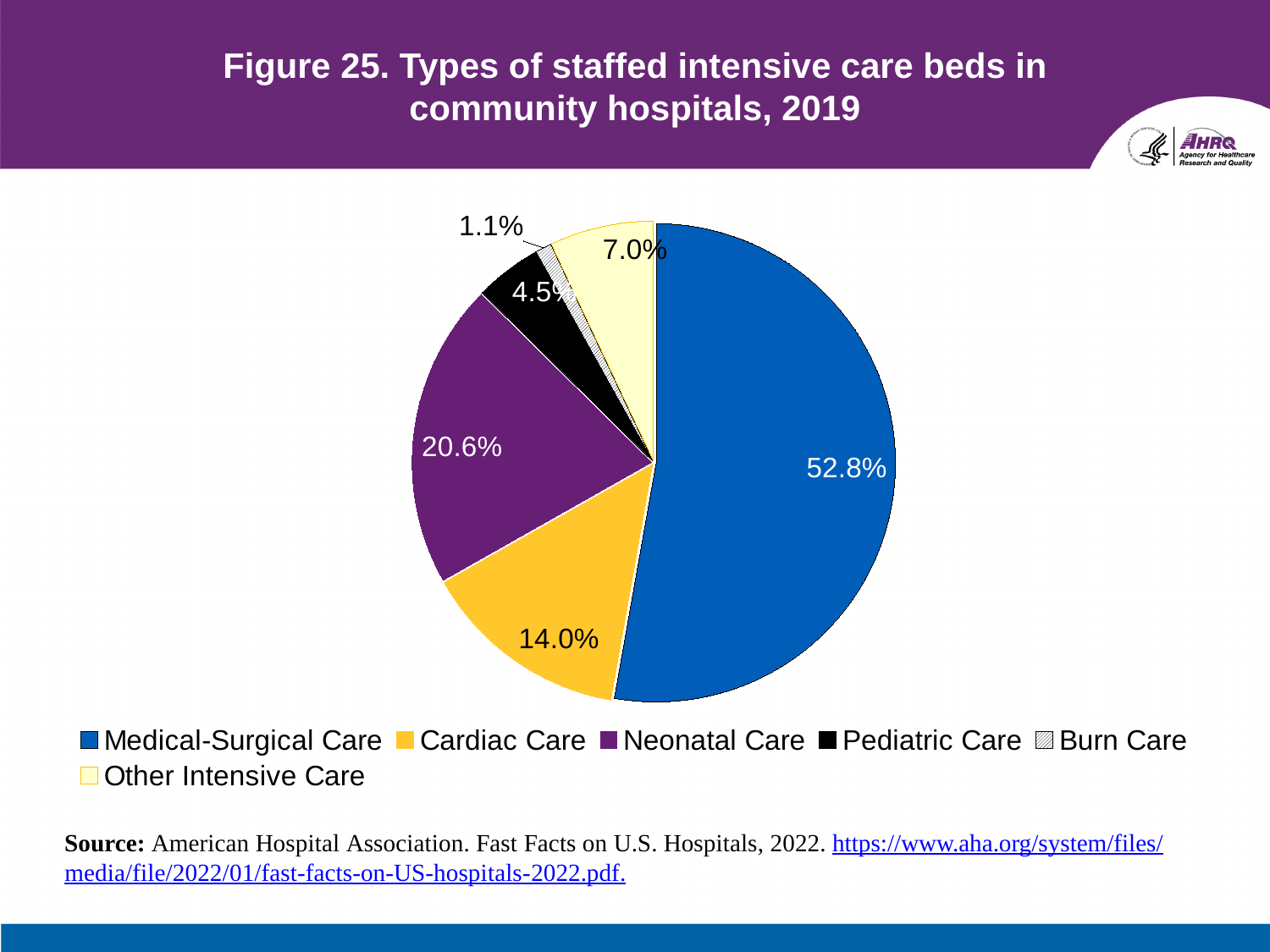
What share of staffed intensive care beds is Medical-Surgical Care? 52.8% Which has a larger share, Other Intensive Care or Pediatric Care? Other Intensive Care What kind of chart is shown on the slide? Pie chart What is the difference in percentage points between the Neonatal Care and Cardiac Care shares? 6.6 percentage points What share of staffed intensive care beds is Pediatric Care? 4.5% What share of staffed intensive care beds is Cardiac Care? 14.0% What share of staffed intensive care beds is Burn Care? 1.1% How many types of staffed intensive care beds are shown in the pie chart? 6 Which type of staffed intensive care bed has the smallest share? Burn Care What share of staffed intensive care beds is Neonatal Care? 20.6% Which type of staffed intensive care bed has the largest share? Medical-Surgical Care What share of staffed intensive care beds is Other Intensive Care? 7.0%